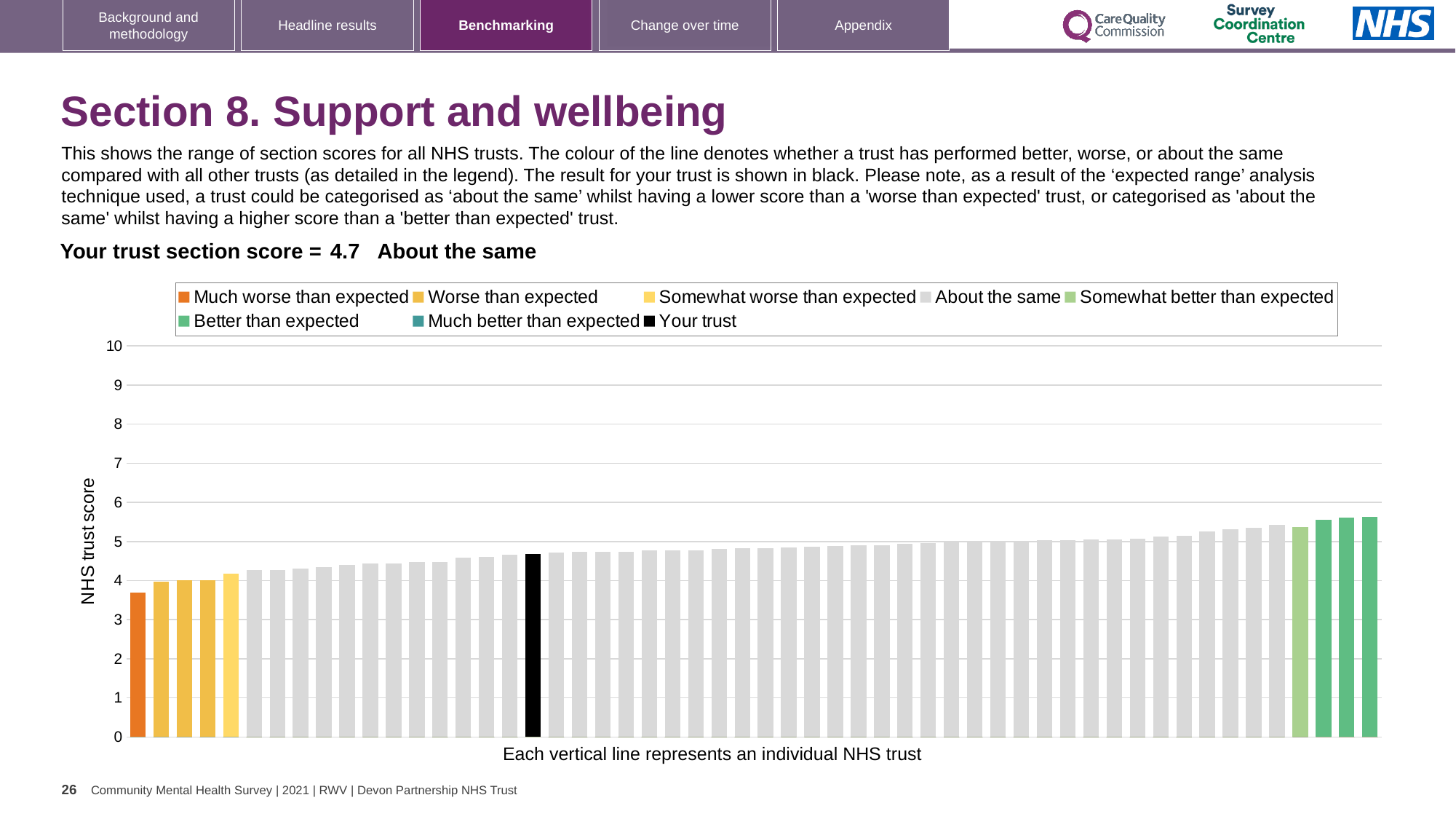
What is the label on the vertical axis of the chart? NHS trust score Is the value for your trust (the black bar) greater or less than 5? less What is the section score for your trust shown on the chart? 4.7 Is the value of the rightmost bar greater or less than 6? less How many entries does the chart legend list? 8 Which legend category does the lowest bar on the chart belong to? Much worse than expected What kind of chart is shown on the slide? bar chart Is the value of the leftmost (orange) bar greater or less than 4? less Do the bar values rise or fall from left to right along the x axis? rise Which legend category does the highest bar on the chart belong to? Better than expected